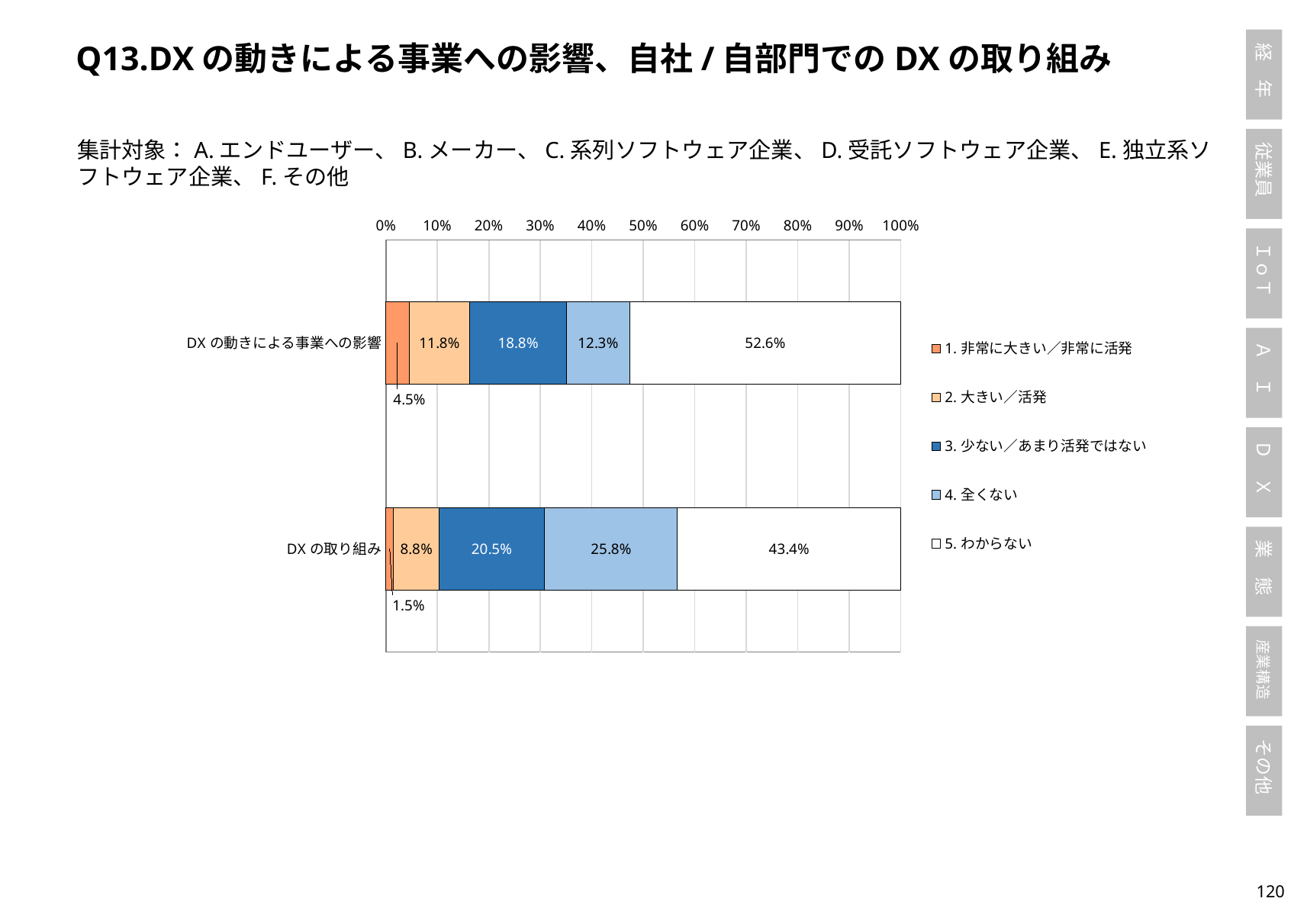
What is the combined value of "1. 非常に大きい／非常に活発" and "2. 大きい／活発" for "DXの取り組み"? 10.3% Which series has the largest value for "DXの取り組み"? 5. わからない How many series does the legend list? 5 Which category has the higher value for "3. 少ない／あまり活発ではない"? DXの取り組み How many categories are plotted on the chart? 2 What is the value of "4. 全くない" for "DXの取り組み"? 25.8% Which series has the smallest value for "DXの動きによる事業への影響"? 1. 非常に大きい／非常に活発 What is the value of "5. わからない" for "DXの動きによる事業への影響"? 52.6% What is the difference between the "5. わからない" values for "DXの動きによる事業への影響" and "DXの取り組み"? 9.2% What is the value of "2. 大きい／活発" for "DXの動きによる事業への影響"? 11.8% What kind of chart is shown on the slide? stacked bar chart What is the value of "1. 非常に大きい／非常に活発" for "DXの取り組み"? 1.5%